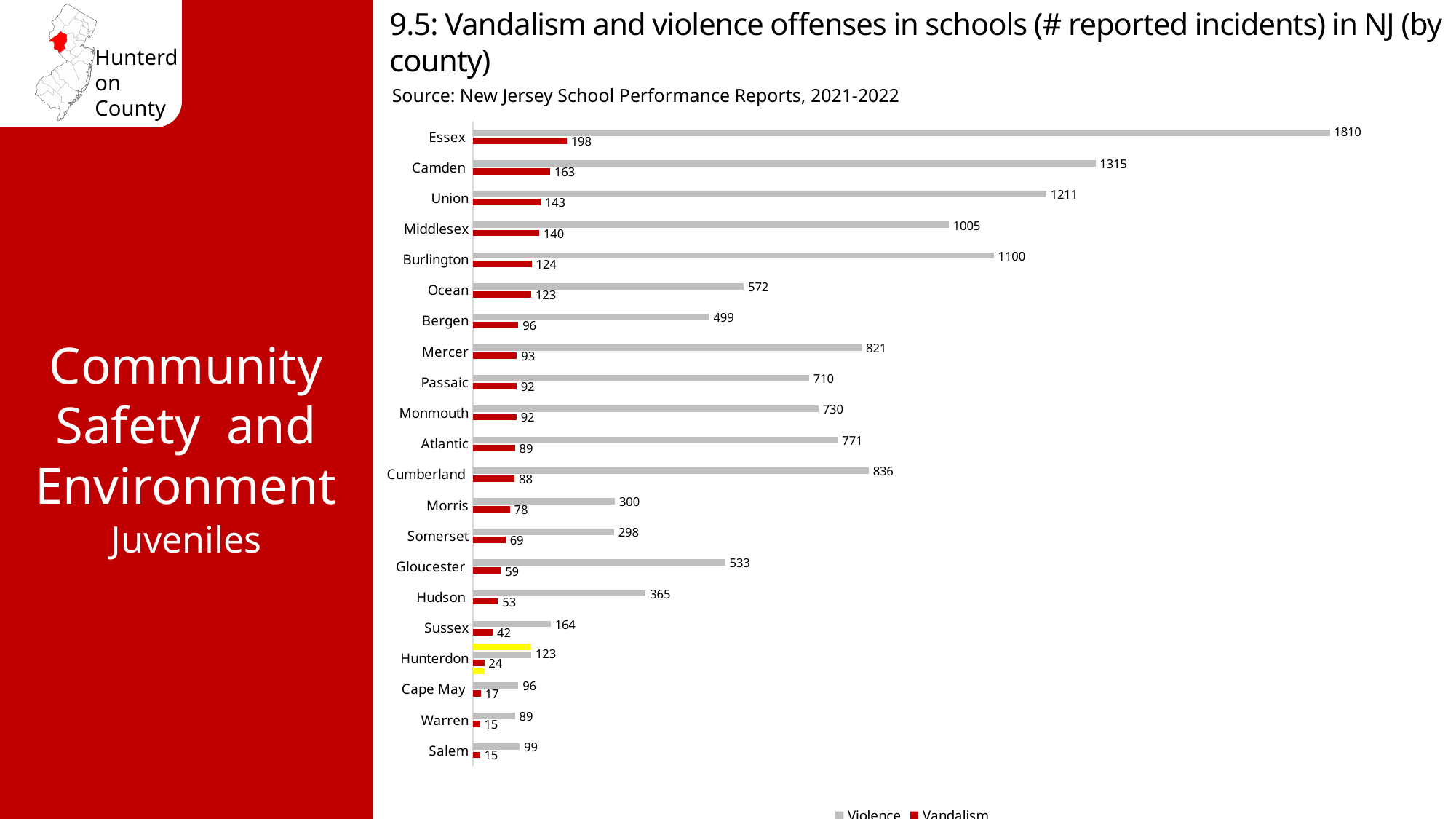
How many counties are shown in the chart? 21 Which county has the lowest number of violence incidents? Warren What is the number of reported vandalism incidents for Hunterdon County? 24 Which series is shown in red? Vandalism What is the difference between violence and vandalism incidents in Hunterdon County? 99 What kind of chart is shown on the slide? Bar chart What is the difference between the violence incidents in Essex and Camden? 495 What is the number of reported violence incidents for Hunterdon County? 123 How many series does the legend list? 2 Which county has the highest number of violence incidents? Essex What is the number of vandalism incidents for Gloucester County? 59 Which county has more violence incidents, Mercer or Cumberland? Cumberland